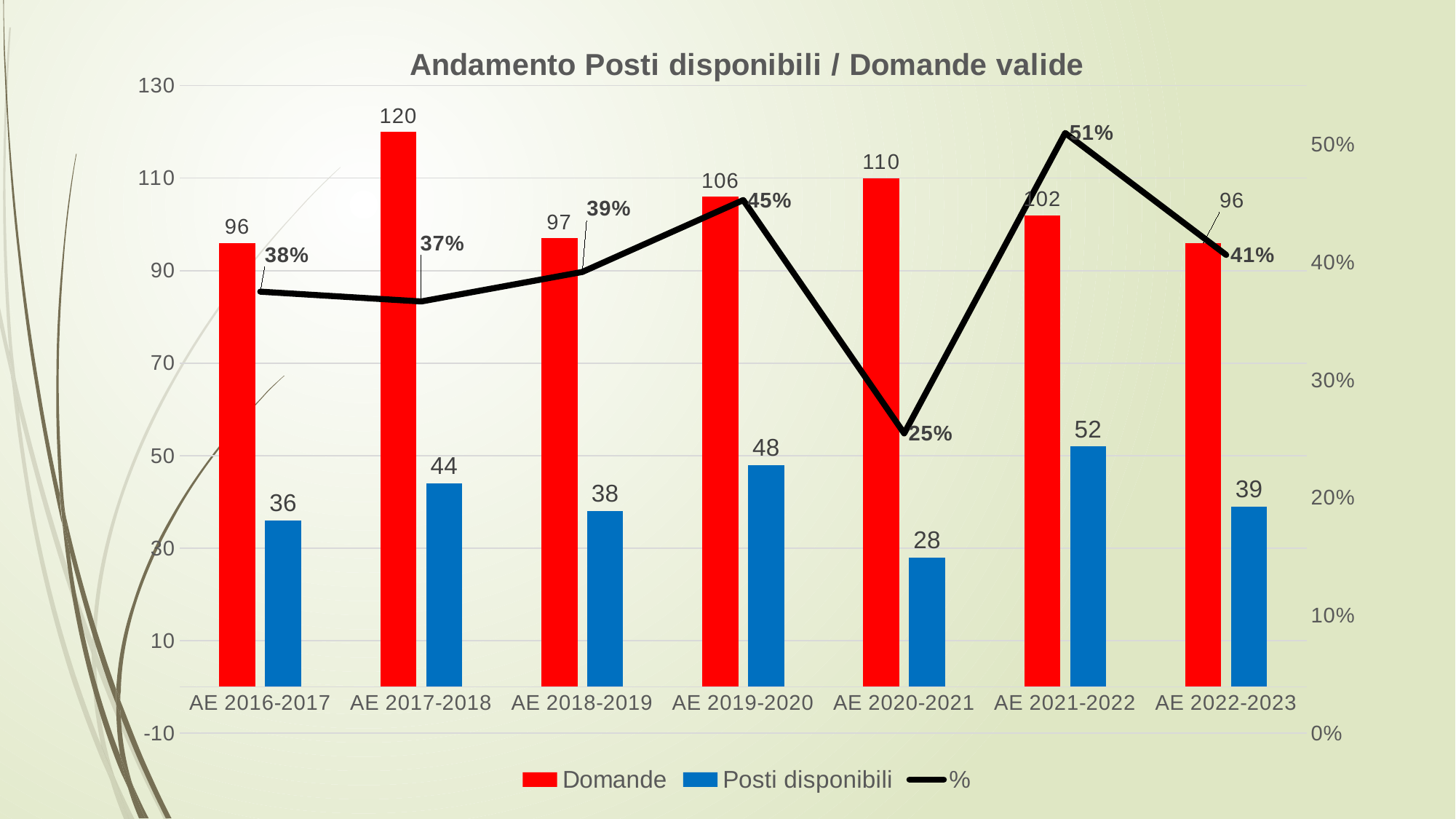
What percentage is shown for AE 2020-2021? 25% How many series does the legend list? 3 How many academic years are shown on the x axis? 7 Which academic year has the highest Domande value? AE 2017-2018 Which is larger: Posti disponibili for AE 2017-2018 or for AE 2022-2023? AE 2017-2018 What is the value of Domande for AE 2017-2018? 120 What is the value of Posti disponibili for AE 2021-2022? 52 What is the difference between Domande and Posti disponibili for AE 2019-2020? 58 What is the title of the chart? Andamento Posti disponibili / Domande valide Which academic year has the lowest Posti disponibili value? AE 2020-2021 What kind of chart is this? Combined bar and line chart Which academic year has the highest percentage value? AE 2021-2022